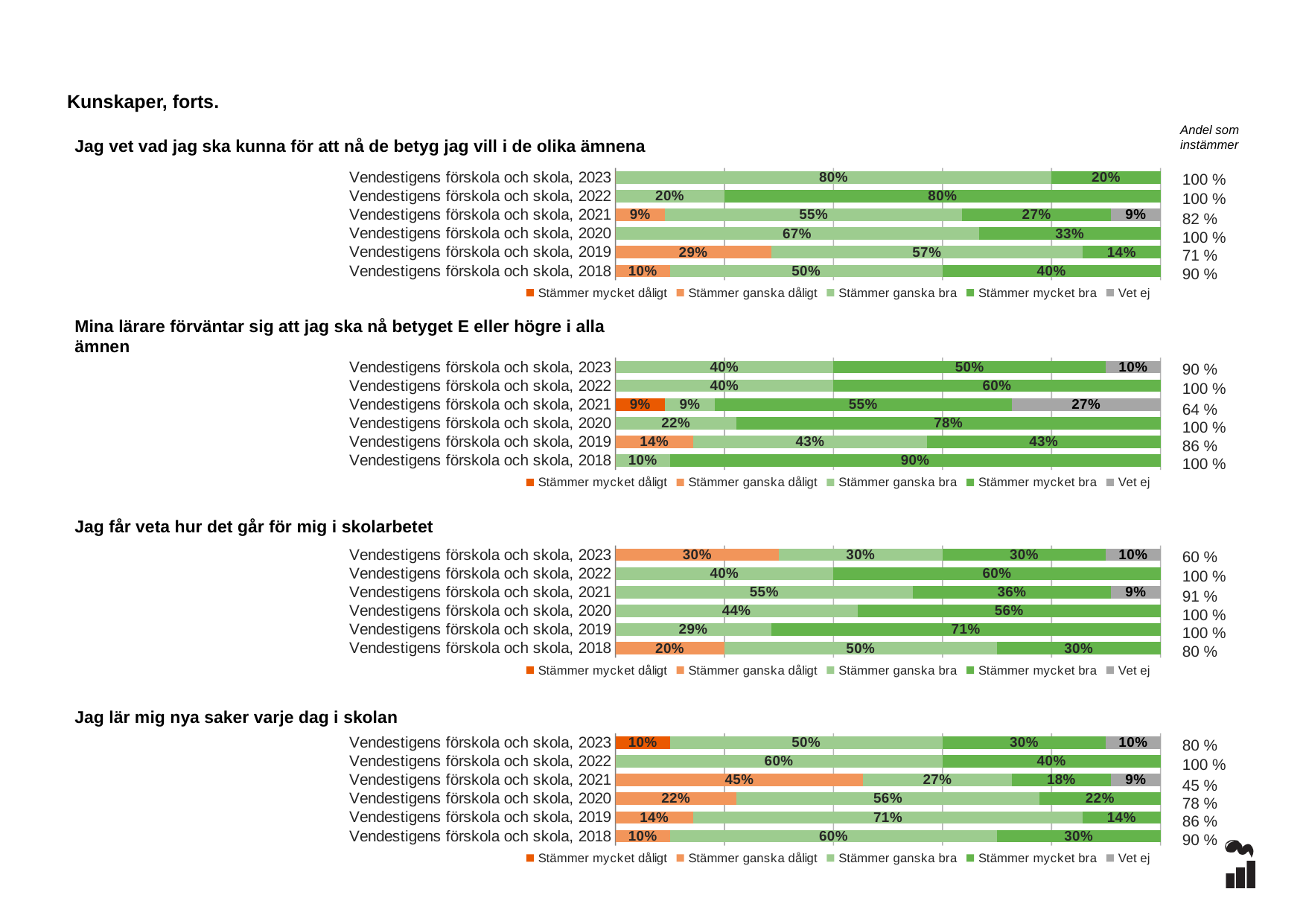
In the chart 'Mina lärare förväntar sig att jag ska nå betyget E eller högre i alla ämnen', what is the 'Stämmer mycket bra' value for Vendestigens förskola och skola, 2018? 90% In the chart 'Mina lärare förväntar sig att jag ska nå betyget E eller högre i alla ämnen', what is the 'Vet ej' value for Vendestigens förskola och skola, 2021? 27% In the chart 'Jag vet vad jag ska kunna för att nå de betyg jag vill i de olika ämnena', what is the 'Stämmer ganska bra' value for Vendestigens förskola och skola, 2023? 80% In the chart 'Jag lär mig nya saker varje dag i skolan', is the 'Stämmer ganska bra' value larger for 2019 or for 2020? 2019 What kind of chart is 'Jag får veta hur det går för mig i skolarbetet'? Stacked bar chart In the chart 'Jag får veta hur det går för mig i skolarbetet', which year has the lowest 'Andel som instämmer'? Vendestigens förskola och skola, 2023 How many bars (years) are shown in the chart 'Mina lärare förväntar sig att jag ska nå betyget E eller högre i alla ämnen'? 6 In the chart 'Jag lär mig nya saker varje dag i skolan', which year has the lowest 'Andel som instämmer'? Vendestigens förskola och skola, 2021 In the chart 'Jag vet vad jag ska kunna för att nå de betyg jag vill i de olika ämnena', what is the 'Stämmer ganska dåligt' value for Vendestigens förskola och skola, 2019? 29% In the chart 'Jag får veta hur det går för mig i skolarbetet', what is the difference between the 'Stämmer mycket bra' values for 2019 and 2018? 41% In the chart 'Jag lär mig nya saker varje dag i skolan', what is the 'Stämmer ganska dåligt' value for Vendestigens förskola och skola, 2021? 45% How many series does the legend list for the chart 'Jag vet vad jag ska kunna för att nå de betyg jag vill i de olika ämnena'? 5